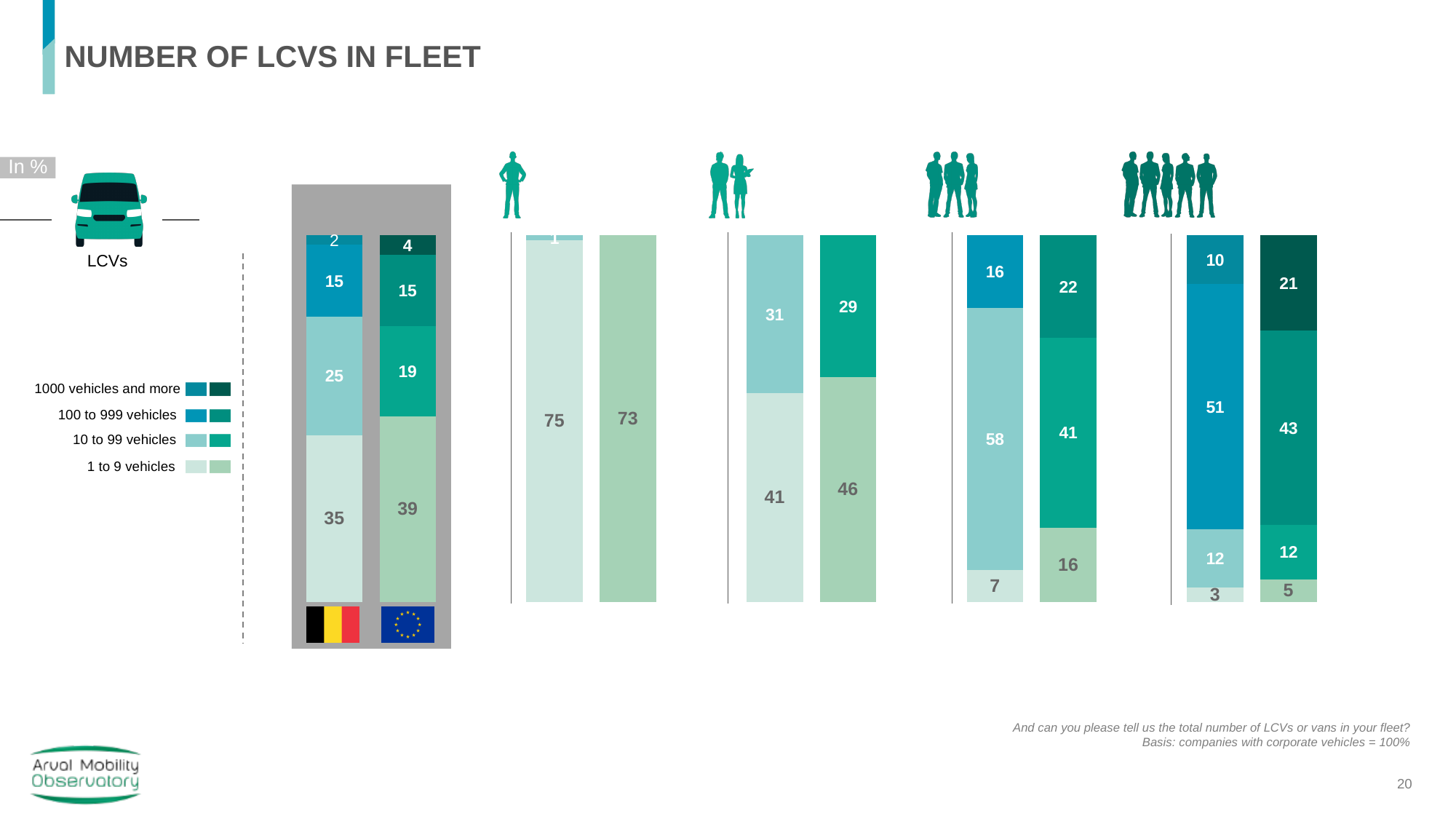
In the EU bar of the grey box, what percentage of companies have 1000 vehicles and more? 4 How many fleet-size categories does the legend list? 4 In the Belgium bar of the grey box, what is the value for 100 to 999 vehicles? 15 What kind of chart is used on this slide? Stacked bar chart In the third pair of bars to the right of the grey box, what is the Belgium value for 10 to 99 vehicles? 58 In the rightmost pair of bars, what is the Belgium value for 100 to 999 vehicles? 51 In the Belgium bar of the grey box, what percentage of companies have 1 to 9 LCVs? 35 In the Belgium bar of the grey box, which fleet-size category has the largest share? 1 to 9 vehicles In the grey box, what is the difference between the EU and Belgium values for 1 to 9 vehicles? 4 In the rightmost pair of bars, what is the EU value for 1 to 9 vehicles? 5 In the grey box, which has the larger value for 10 to 99 vehicles, Belgium or the EU? Belgium In what unit are the values on the chart expressed? In %